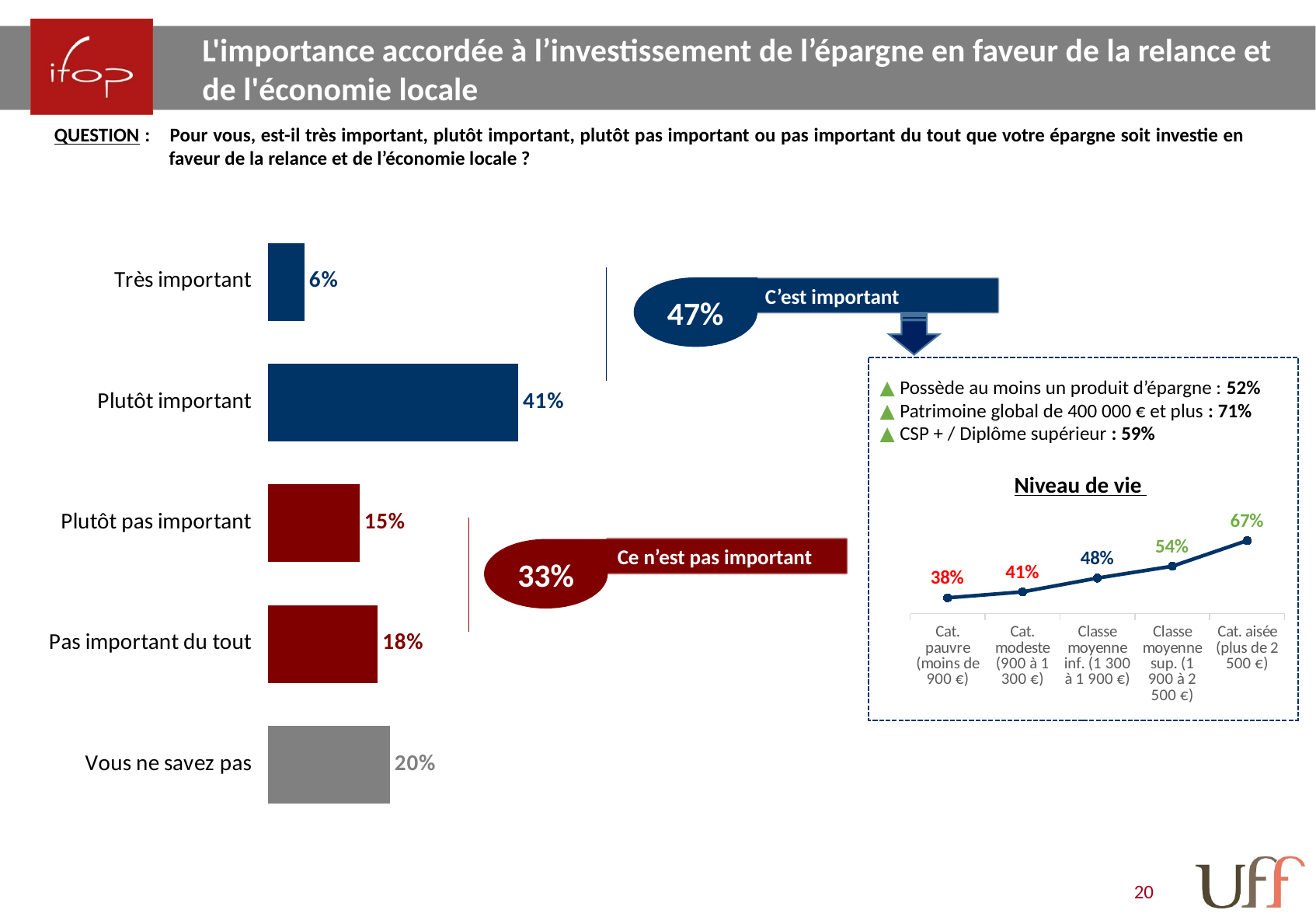
In the bar chart on the left, what is the value for "Vous ne savez pas"? 20% In the "Niveau de vie" chart, do the values rise or fall from "Cat. pauvre" to "Cat. aisée"? Rise How many categories does the bar chart on the left show? 5 In the bar chart on the left, what is the value for "Plutôt important"? 41% In the "Niveau de vie" chart, what is the difference between "Cat. aisée (plus de 2 500 €)" and "Cat. pauvre (moins de 900 €)"? 29% What kind of chart is the "Niveau de vie" chart? Line chart In the "Niveau de vie" chart, what is the value for "Classe moyenne inf. (1 300 à 1 900 €)"? 48% In the bar chart on the left, which is larger: "Plutôt pas important" or "Vous ne savez pas"? Vous ne savez pas In the bar chart on the left, which category has the lowest value? Très important What kind of chart is the chart on the left? Bar chart In the bar chart on the left, what is the difference between "Pas important du tout" and "Plutôt pas important"? 3% In the bar chart on the left, which category has the highest value? Plutôt important